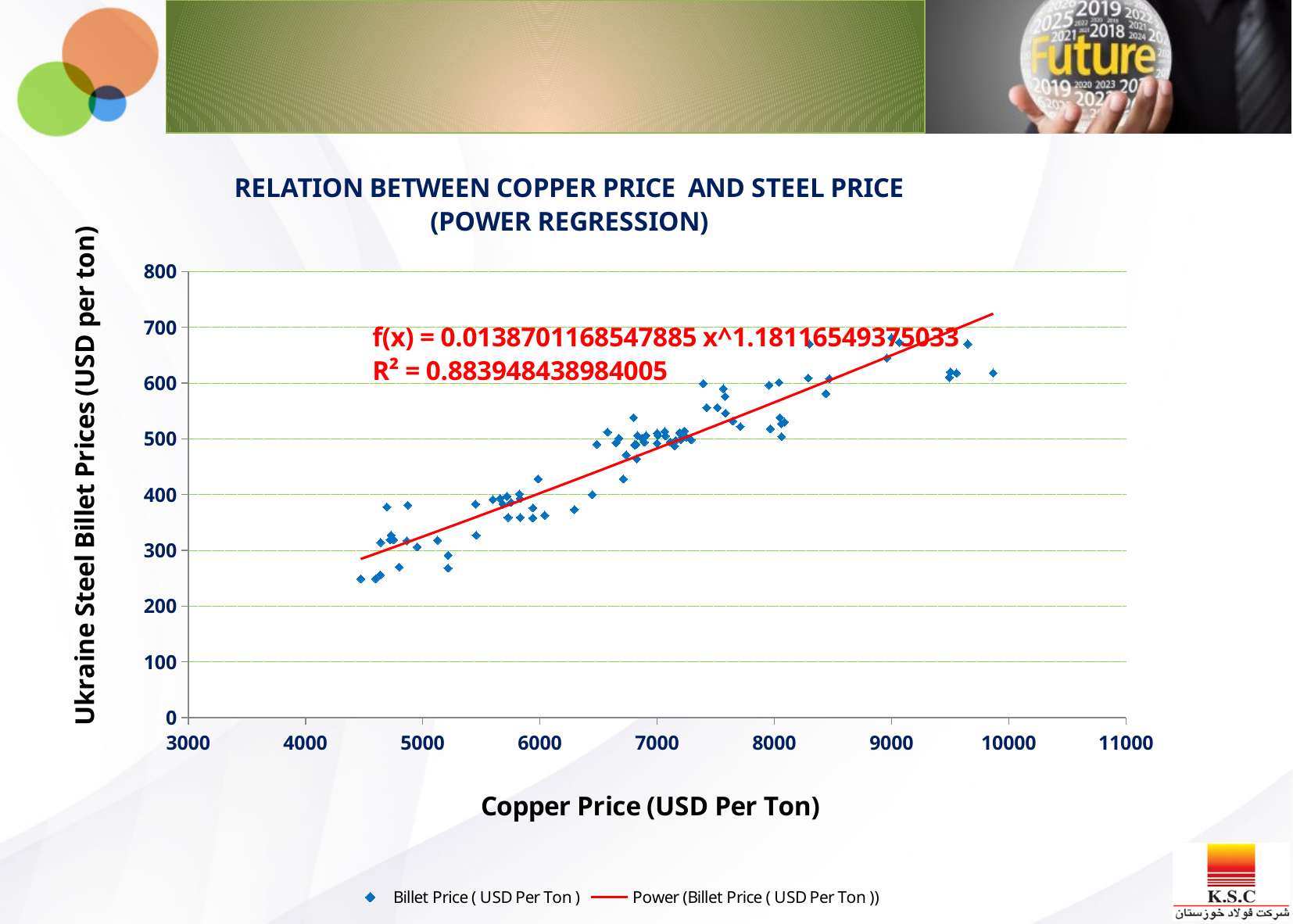
Is the billet price for the point with the highest copper price (near 9900) greater or less than 500? greater Do the billet prices rise or fall as copper price increases along the x axis? Rise What is the exponent in the power regression equation shown on the chart? 1.18116549375033 What is the title of the chart? RELATION BETWEEN COPPER PRICE AND STEEL PRICE (POWER REGRESSION) What is the R² value shown on the chart? R² = 0.883948438984005 How many entries does the chart legend list? 2 Are billet prices higher for points at a copper price around 9000 or around 5000? Around 9000 What kind of chart is shown on the slide? Scatter chart with a trendline What is the regression equation printed on the chart? f(x) = 0.0138701168547885 x^1.18116549375033 What is the label of the x axis? Copper Price (USD Per Ton) What is the highest value shown on the y axis? 800 Is the billet price for the point with the lowest copper price (near 4500) greater or less than 300? less